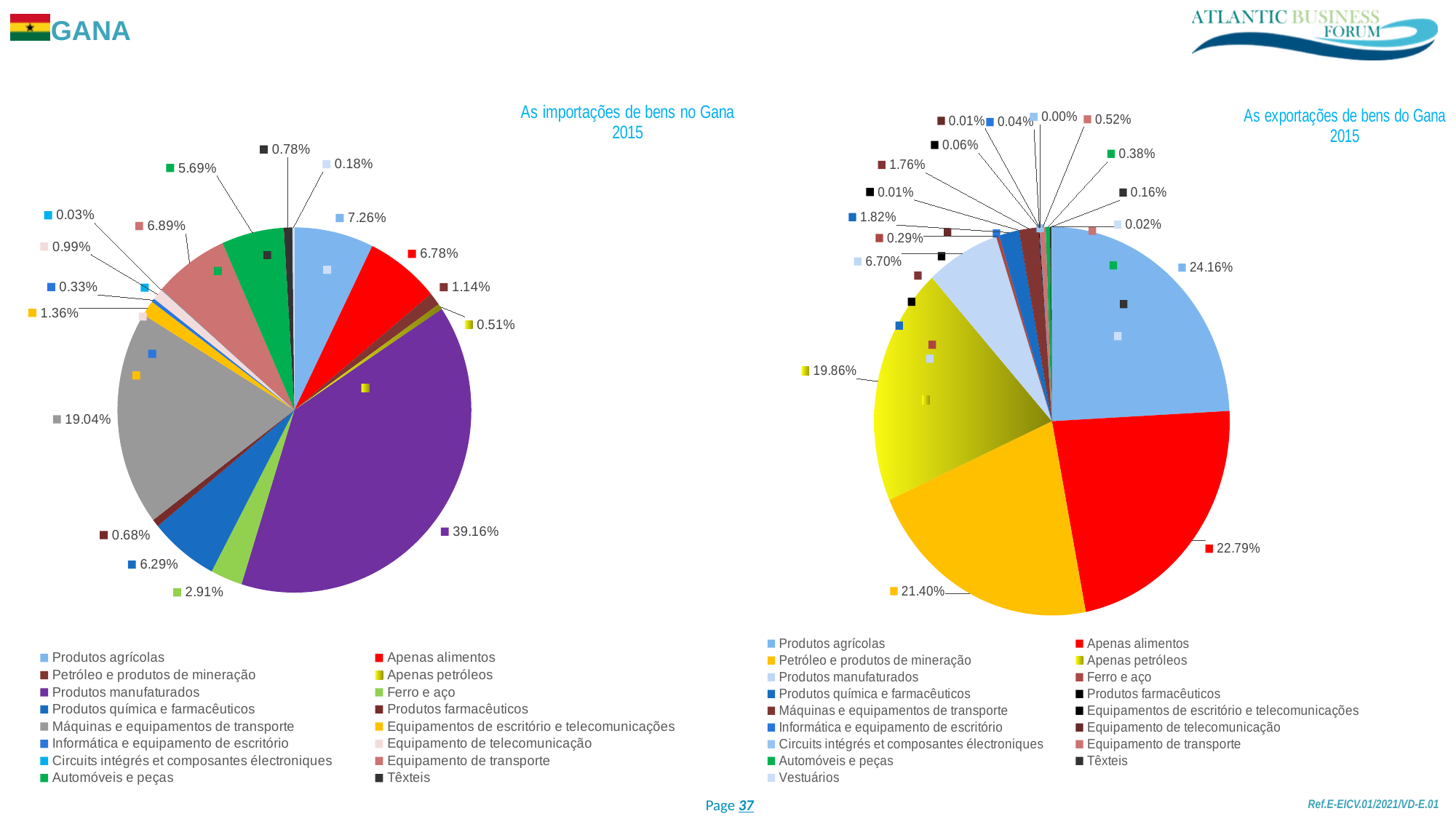
In the chart 'As importações de bens no Gana 2015', what share do Produtos manufaturados have? 39.16% What type of chart is used for 'As importações de bens no Gana 2015'? Pie chart In the chart 'As importações de bens no Gana 2015', which is larger: Equipamento de transporte or Automóveis e peças? Equipamento de transporte How many entries does the legend of the chart 'As exportações de bens do Gana 2015' list? 17 In the chart 'As exportações de bens do Gana 2015', what is the share for Apenas alimentos? 22.79% In the chart 'As importações de bens no Gana 2015', which category has the largest share? Produtos manufaturados In the chart 'As exportações de bens do Gana 2015', what is the difference between the shares of Produtos agrícolas and Apenas petróleos? 4.30% In the chart 'As exportações de bens do Gana 2015', which is larger: Produtos manufaturados or Produtos química e farmacêuticos? Produtos manufaturados In the chart 'As exportações de bens do Gana 2015', what is the share for Petróleo e produtos de mineração? 21.40% In the chart 'As exportações de bens do Gana 2015', which category has the largest share? Produtos agrícolas In the chart 'As importações de bens no Gana 2015', what is the difference between the shares of Produtos agrícolas and Apenas alimentos? 0.48% In the chart 'As importações de bens no Gana 2015', what is the share for Máquinas e equipamentos de transporte? 19.04%